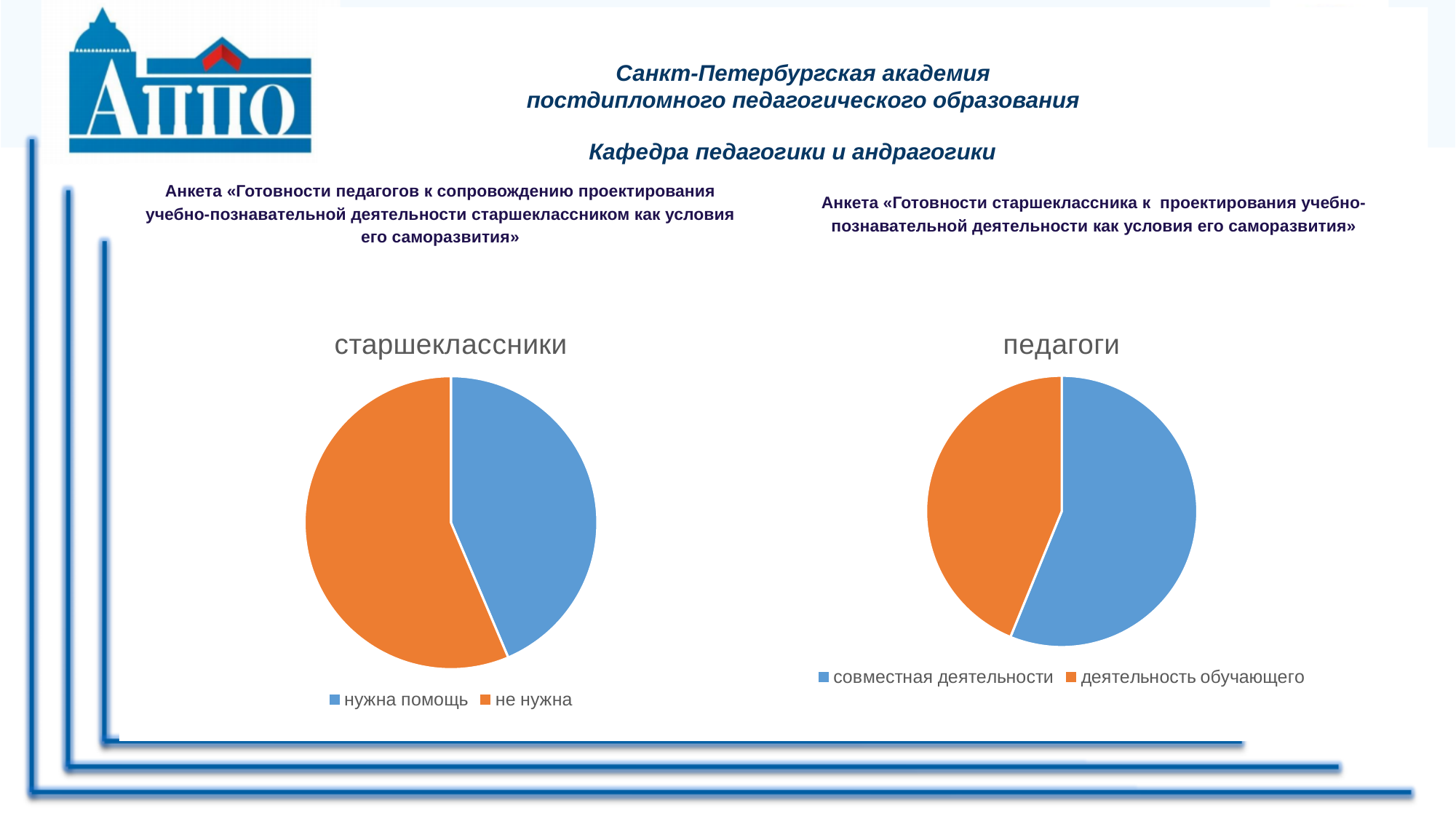
In the chart titled «педагоги», how many entries does the legend list? 2 In the chart titled «педагоги», which slice is the largest? совместная деятельности In the chart titled «старшеклассники», which slice is the largest? не нужна In the chart titled «старшеклассники», which slice is the smallest? нужна помощь In the chart titled «педагоги», which is larger: «совместная деятельности» or «деятельность обучающего»? совместная деятельности What kind of chart is the chart titled «старшеклассники»? pie chart In the chart titled «старшеклассники», how many slices does the pie have? 2 In the chart titled «педагоги», which slice is the smallest? деятельность обучающего In the chart titled «педагоги», what colour is the slice for «деятельность обучающего»? orange What kind of chart is the chart titled «педагоги»? pie chart In the chart titled «старшеклассники», which is larger: «нужна помощь» or «не нужна»? не нужна What is the title of the pie chart on the left side of the slide? старшеклассники